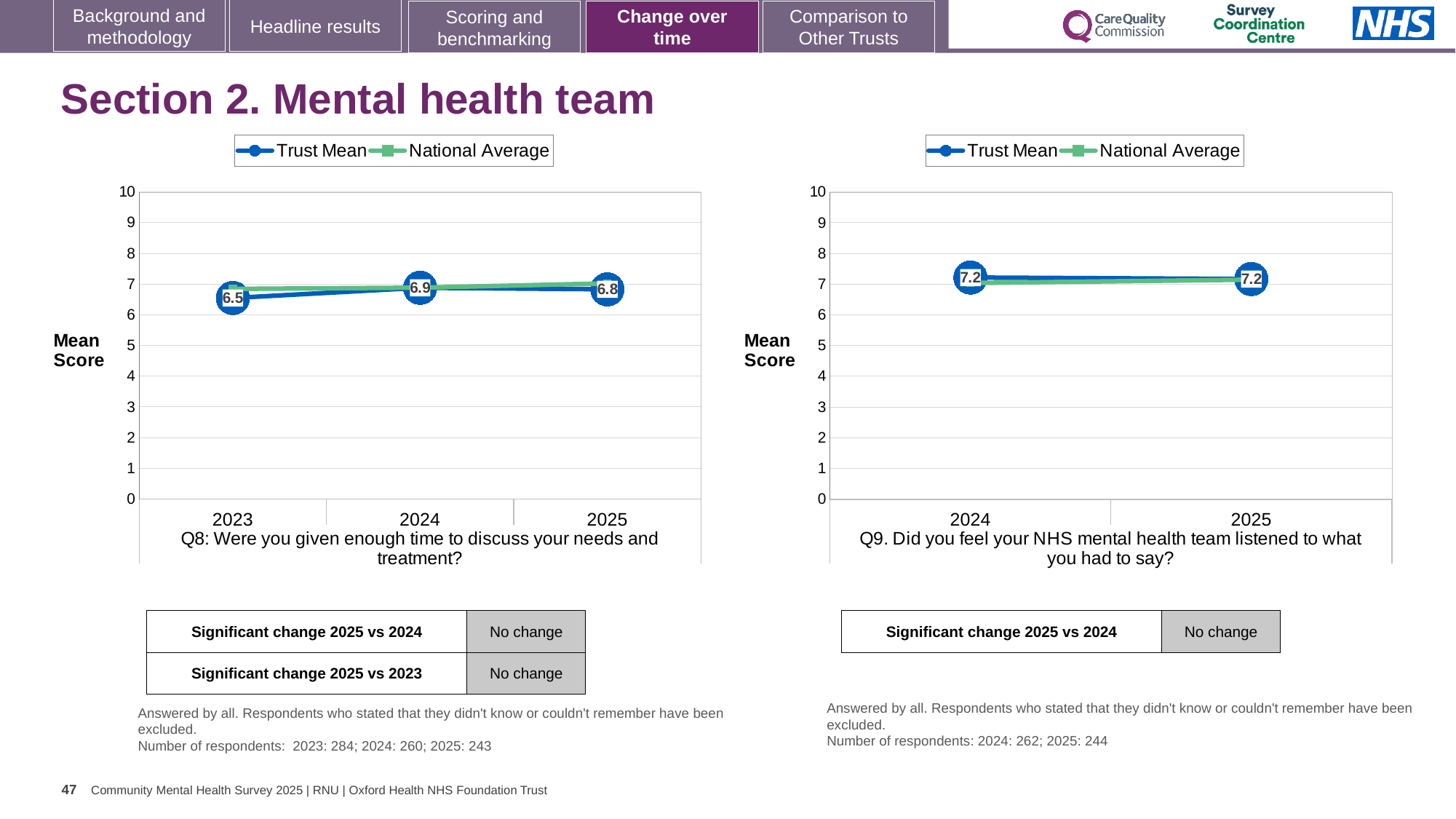
What type of chart is used for Q8 on the left? Line chart How many series does the legend of the right chart (Q9) list? 2 In the left chart (Q8), which year has the lowest Trust Mean score? 2023 In the right chart (Q9), how does the Trust Mean score change from 2024 to 2025? It stays the same at 7.2 In the right chart (Q9), what is the Trust Mean score for 2024? 7.2 In the left chart (Q8), what is the Trust Mean score for 2023? 6.5 In the left chart (Q8), what is the difference between the Trust Mean scores for 2024 and 2023? 0.4 In the left chart (Q8), what is the Trust Mean score for 2025? 6.8 In the left chart (Q8), which year has the highest Trust Mean score? 2024 In the left chart (Q8), is the National Average value for 2025 greater or less than 8? less In the left chart (Q8), is the Trust Mean score for 2024 larger than the score for 2023? Yes How many years are plotted in the left chart (Q8)? 3